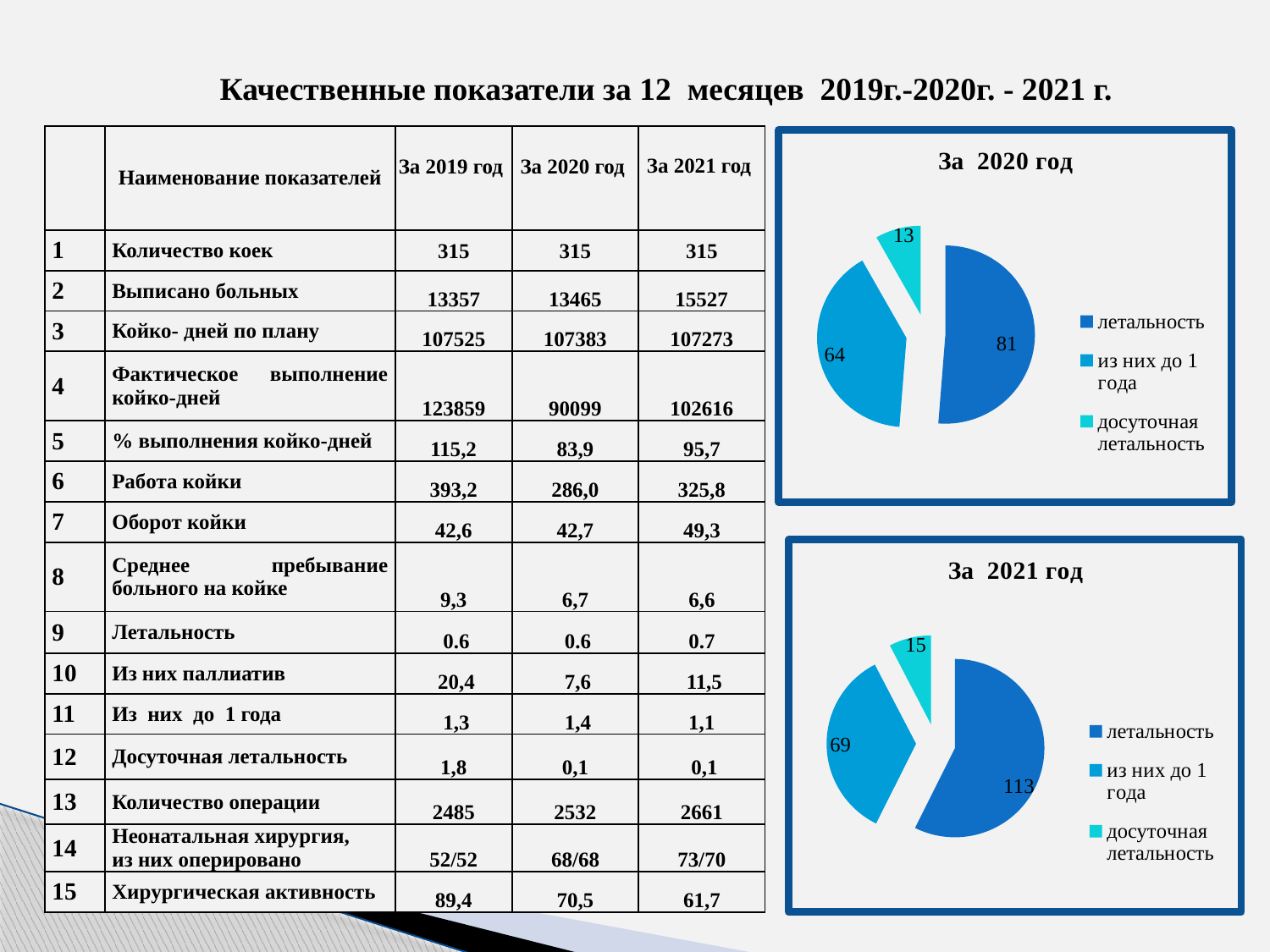
In the chart titled 'За 2020 год', what is the value for 'летальность'? 81 In the chart titled 'За 2020 год', what is the value for 'досуточная летальность'? 13 In the chart titled 'За 2020 год', which category has the largest slice? летальность In the chart titled 'За 2021 год', what share of the total does 'досуточная летальность' represent, to the nearest whole percent? 8% What type of chart is the chart titled 'За 2021 год'? pie chart In the chart titled 'За 2021 год', what is the difference between the values for 'летальность' and 'из них до 1 года'? 44 In the chart titled 'За 2021 год', which category has the smallest slice? досуточная летальность In the chart titled 'За 2021 год', which is larger: 'из них до 1 года' or 'досуточная летальность'? из них до 1 года In the chart titled 'За 2021 год', what is the value for 'летальность'? 113 In the chart titled 'За 2021 год', what is the value for 'из них до 1 года'? 69 How many slices does the chart titled 'За 2020 год' have? 3 In the chart titled 'За 2020 год', what is the difference between the values for 'летальность' and 'из них до 1 года'? 17